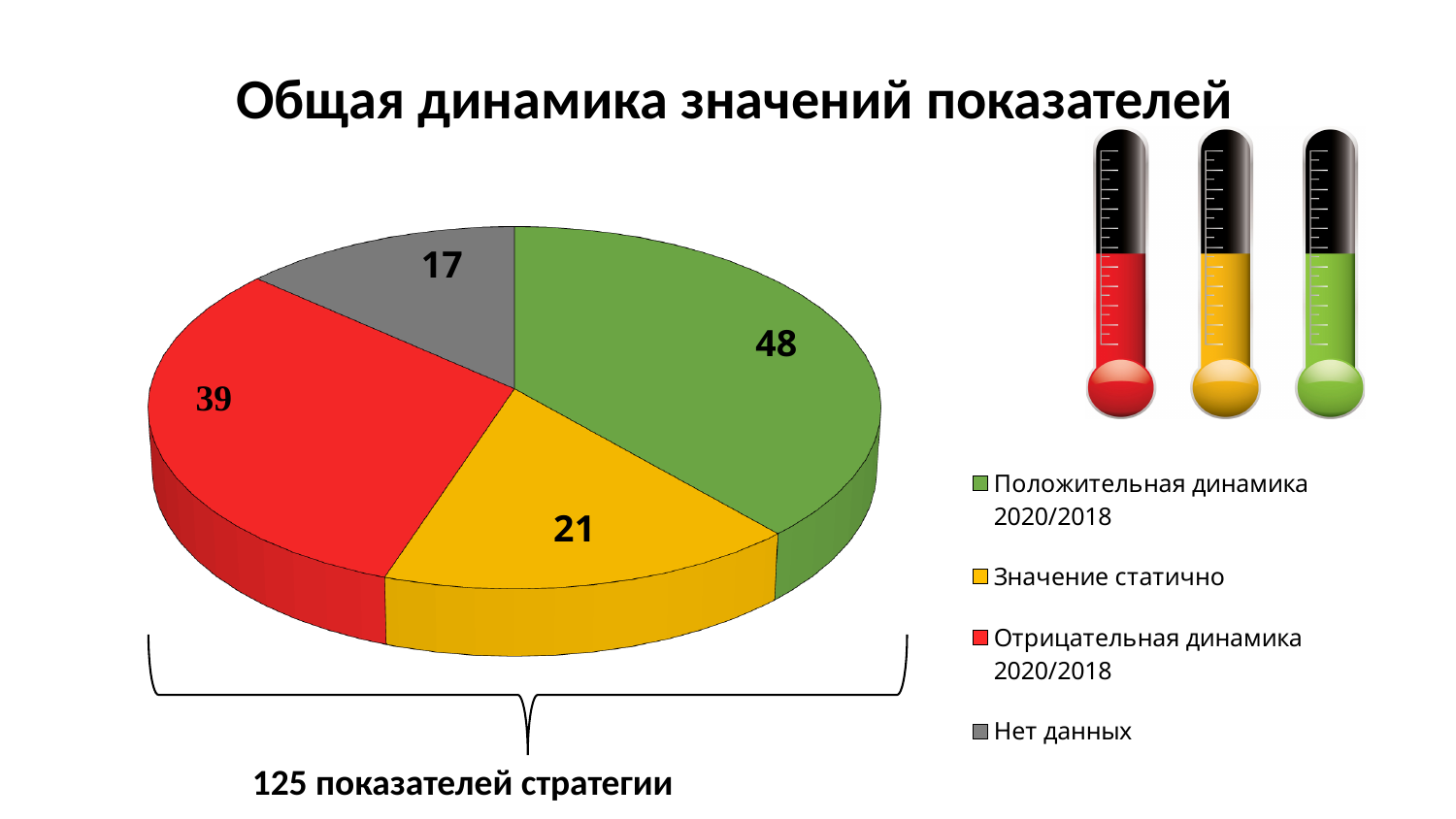
What is the total of all slices in the pie chart? 125 What is the title of the chart? Общая динамика значений показателей What is the value for "Значение статично"? 21 What is the value for "Нет данных"? 17 Which category has the largest slice of the pie? Положительная динамика 2020/2018 How many categories does the pie chart have? 4 What is the difference between the values for "Положительная динамика 2020/2018" and "Отрицательная динамика 2020/2018"? 9 What is the value for "Положительная динамика 2020/2018"? 48 Which category has the smallest slice of the pie? Нет данных What is the value for "Отрицательная динамика 2020/2018"? 39 Which is larger: the value for "Значение статично" or the value for "Нет данных"? Значение статично What type of chart is shown on the slide? Pie chart